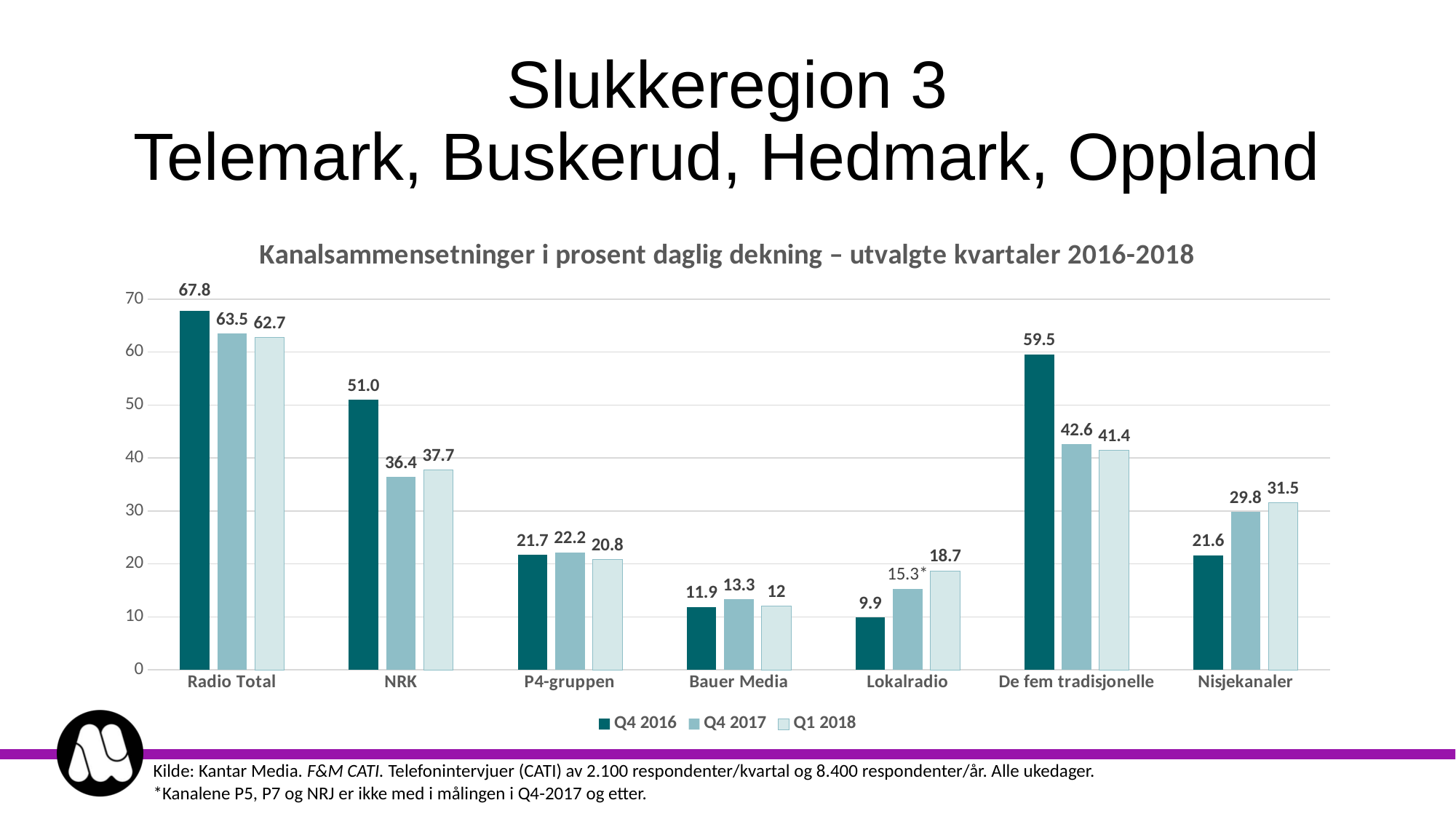
What is the Q4 2016 value for Radio Total? 67.8 What is the difference between the Q4 2016 and Q1 2018 values for NRK? 13.3 How many categories are shown on the x axis? 7 How many series does the legend list? 3 Do the values for Bauer Media rise or fall from Q4 2017 to Q1 2018? Fall Which is larger for Nisjekanaler: the Q4 2017 value or the Q1 2018 value? Q1 2018 Which category has the lowest Q4 2016 value? Lokalradio What is the Q4 2017 value for Lokalradio? 15.3 Is the Q4 2016 value for De fem tradisjonelle greater or less than 50? greater What kind of chart is shown on the slide? Bar chart Which category has the highest Q4 2016 value? Radio Total What is the Q1 2018 value for NRK? 37.7